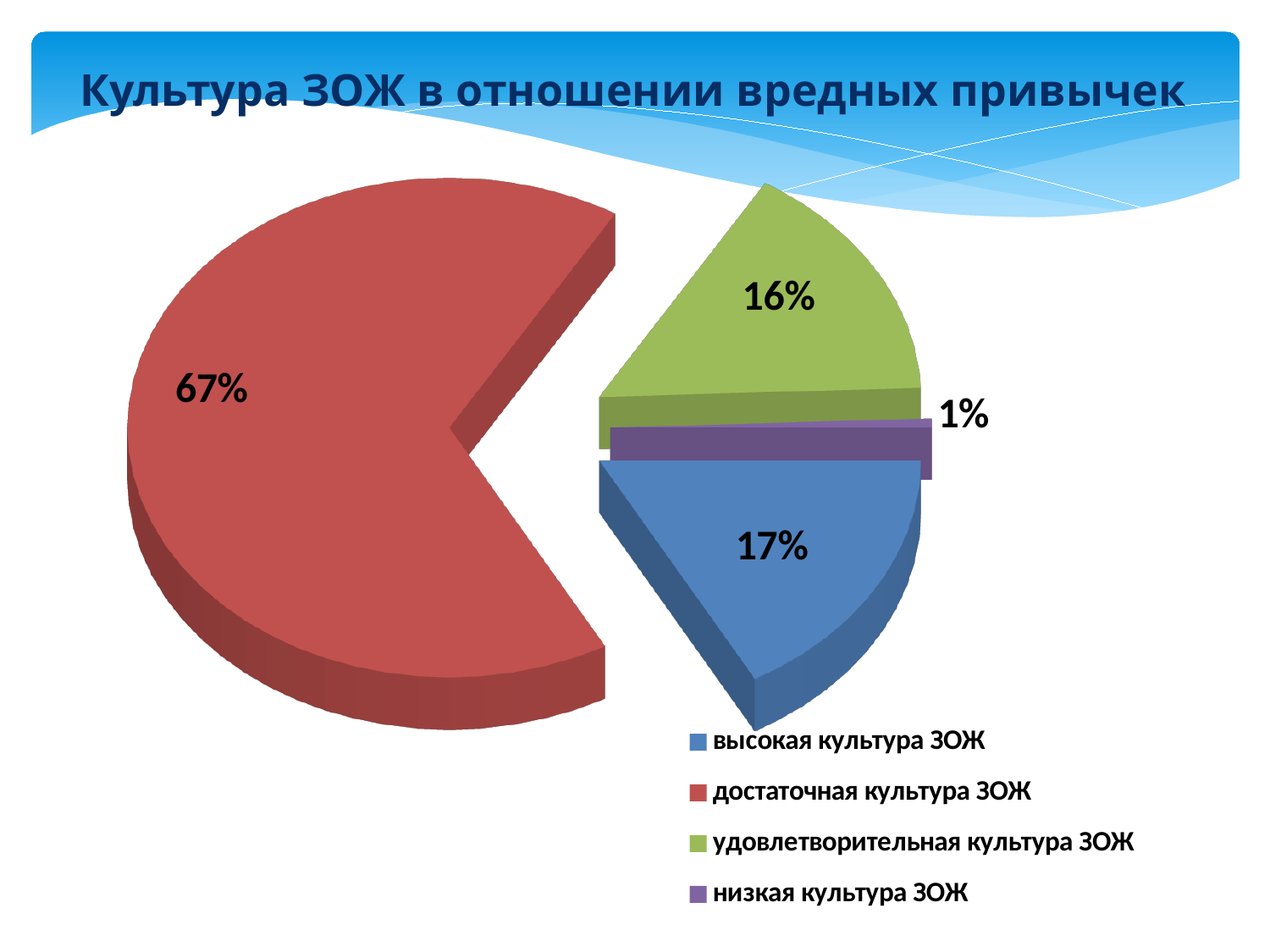
What share of the pie does "низкая культура ЗОЖ" have? 1% What is the title of the chart? Культура ЗОЖ в отношении вредных привычек Which category has the largest slice of the pie? достаточная культура ЗОЖ What share of the pie does "высокая культура ЗОЖ" have? 17% How many categories does the pie chart show? 4 What share of the pie does "удовлетворительная культура ЗОЖ" have? 16% What kind of chart is shown on the slide? pie chart Which category has the smallest slice of the pie? низкая культура ЗОЖ Which is larger: the share of "высокая культура ЗОЖ" or "удовлетворительная культура ЗОЖ"? высокая культура ЗОЖ What is the difference between the shares of "удовлетворительная культура ЗОЖ" and "низкая культура ЗОЖ"? 15% What is the difference between the shares of "достаточная культура ЗОЖ" and "высокая культура ЗОЖ"? 50%